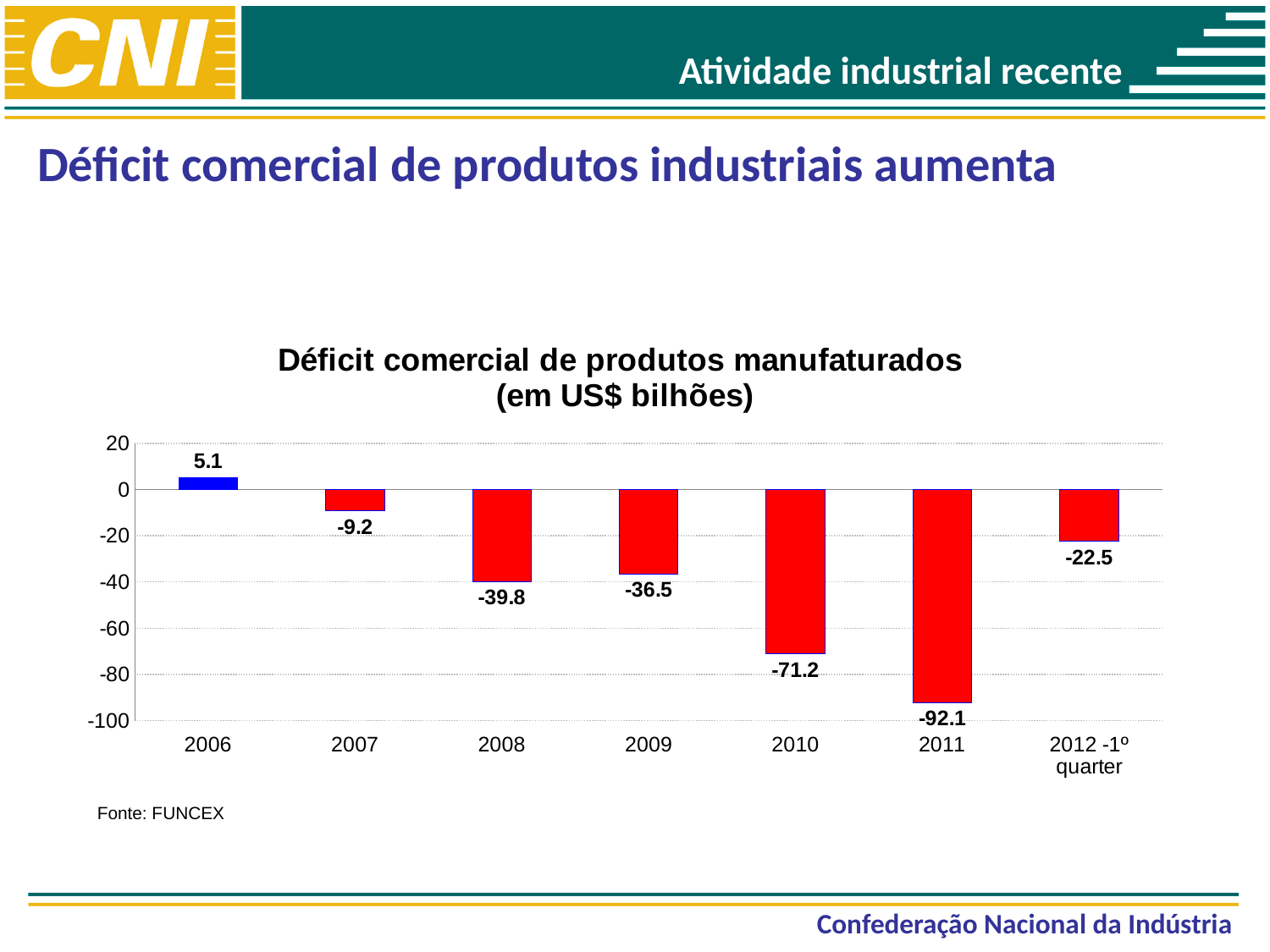
Which is larger, the value for 2008 or the value for 2009? 2009 What is the difference between the values for 2010 and 2011? 20.9 Which category has the highest value? 2006 What is the value for 2009? -36.5 What is the value for 2006? 5.1 Which year has the lowest value? 2011 What is the value for 2012 - 1º quarter? -22.5 What is the value for 2011? -92.1 What kind of chart is shown? bar chart What is the source cited below the chart? FUNCEX Is the value for 2010 greater or less than -60? less How many categories are shown on the x axis? 7